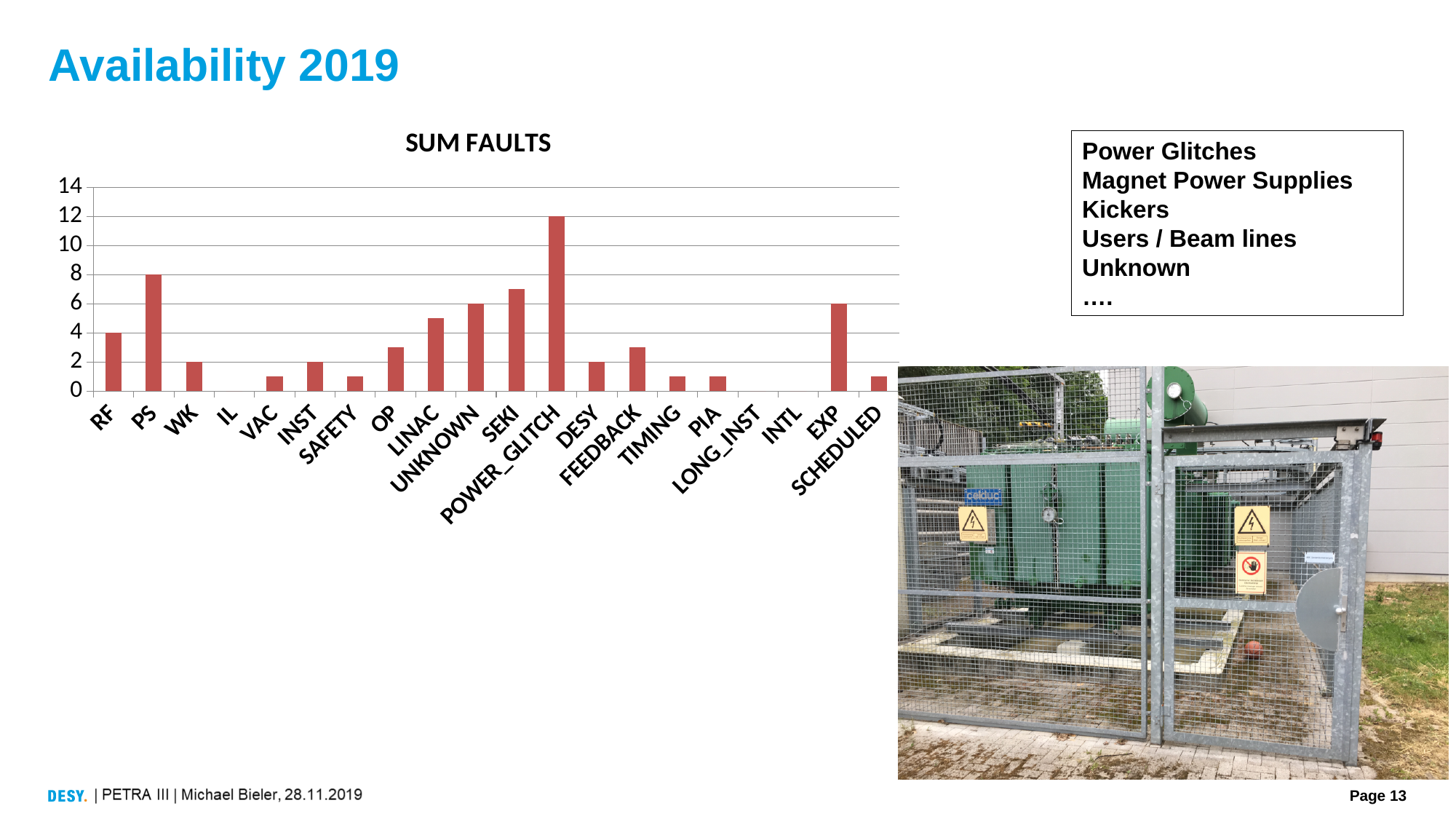
Which category has the highest value in the SUM FAULTS chart? POWER_GLITCH What is the value for PS? 8 What is the value for EXP? 6 How many categories are shown on the x axis of the SUM FAULTS chart? 20 What is the difference between the values for POWER_GLITCH and PS? 4 What is the title of the chart? SUM FAULTS Which is larger, the value for PS or the value for UNKNOWN? PS Is the value for SEKI greater or less than 8? less What is the value for RF? 4 What type of chart is shown on the slide? bar chart Is the value for LINAC greater or less than 4? greater What is the value for POWER_GLITCH? 12